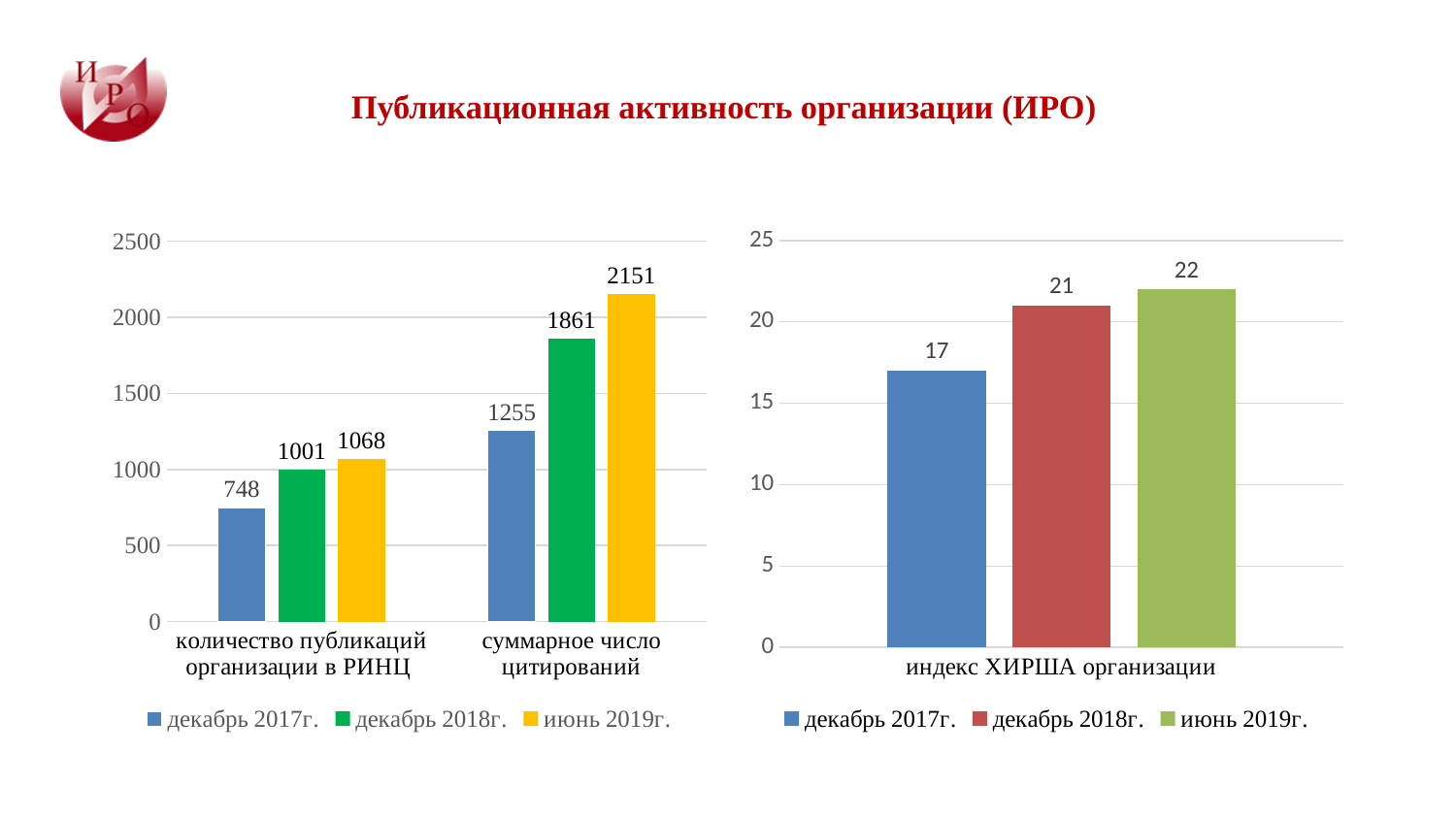
In the right chart, what is the difference between the июнь 2019г. and декабрь 2017г. values? 5 In the left chart, which is larger: 'количество публикаций организации в РИНЦ' in июнь 2019г. or 'суммарное число цитирований' in декабрь 2017г.? суммарное число цитирований in декабрь 2017г. In the left chart, what is the value for 'количество публикаций организации в РИНЦ' in декабрь 2017г.? 748 In the right chart, what is the value for 'индекс ХИРША организации' in декабрь 2018г.? 21 In the right chart, which series has the lowest value? декабрь 2017г. In the left chart, what is the difference between the 'суммарное число цитирований' values for декабрь 2018г. and декабрь 2017г.? 606 How many categories are shown on the x axis of the left chart? 2 What kind of chart is the right chart? bar chart In the left chart, which series has the highest value for 'суммарное число цитирований'? июнь 2019г. How many series does the legend of the right chart list? 3 In the right chart, do the values rise or fall from декабрь 2017г. to июнь 2019г.? rise In the left chart, what is the value for 'суммарное число цитирований' in июнь 2019г.? 2151